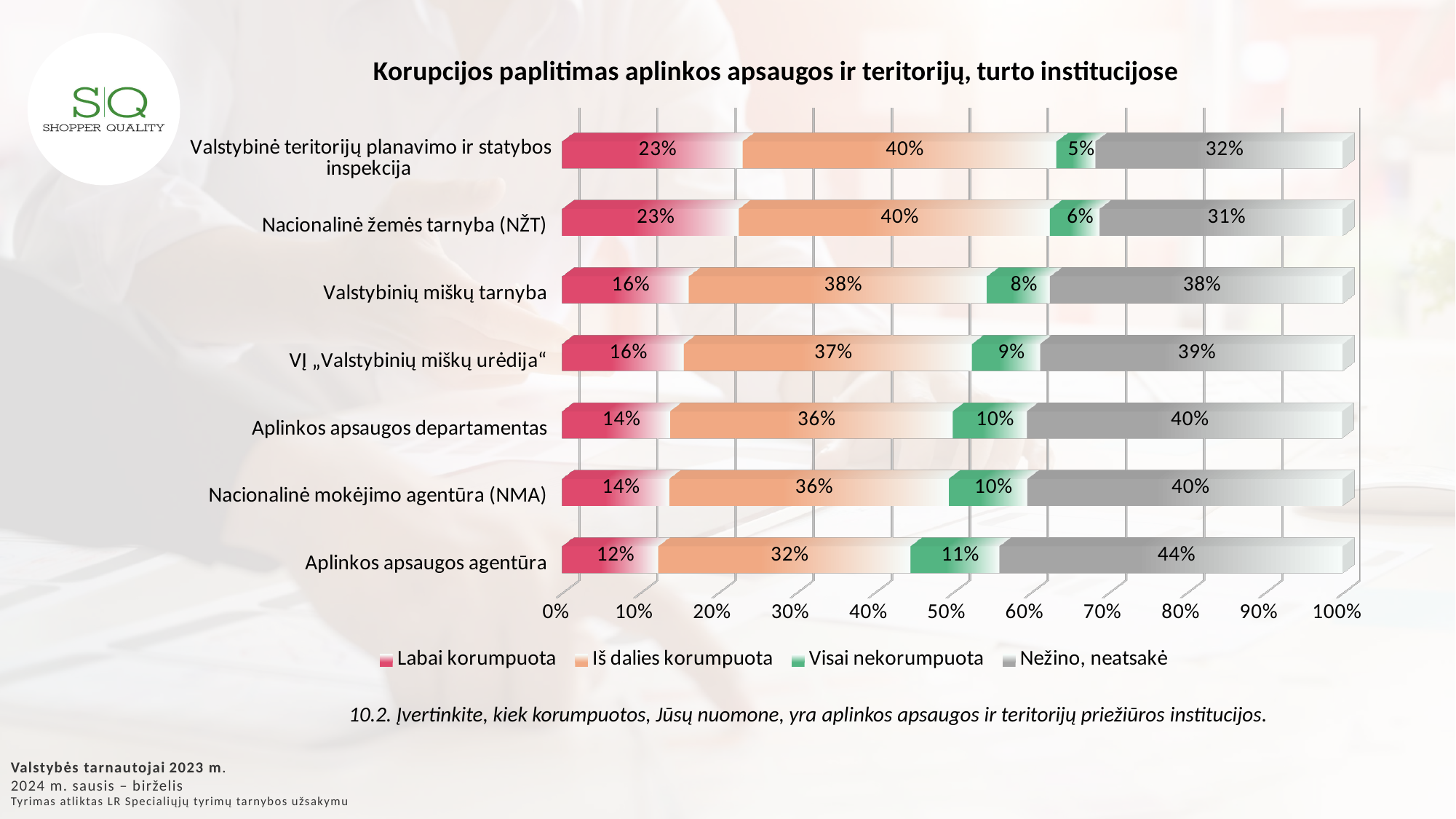
Which institution has the highest "Nežino, neatsakė" share? Aplinkos apsaugos agentūra What is the difference between the "Labai korumpuota" values for Nacionalinė žemės tarnyba (NŽT) and Aplinkos apsaugos agentūra? 11% How many institutions are shown in the chart? 7 What is the "Nežino, neatsakė" value for Aplinkos apsaugos agentūra? 44% What percentage of respondents rated Valstybinių miškų tarnyba as "Labai korumpuota"? 16% What type of chart is shown on the slide? Stacked bar chart How many series does the legend list? 4 Which institution has the lowest "Visai nekorumpuota" share? Valstybinė teritorijų planavimo ir statybos inspekcija What is the "Iš dalies korumpuota" value for VĮ „Valstybinių miškų urėdija“? 37% What is the combined share of "Labai korumpuota" and "Iš dalies korumpuota" for Aplinkos apsaugos departamentas? 50% What is the "Visai nekorumpuota" value for Nacionalinė žemės tarnyba (NŽT)? 6% Which is larger: the "Visai nekorumpuota" value for Aplinkos apsaugos agentūra or for Valstybinių miškų tarnyba? Aplinkos apsaugos agentūra